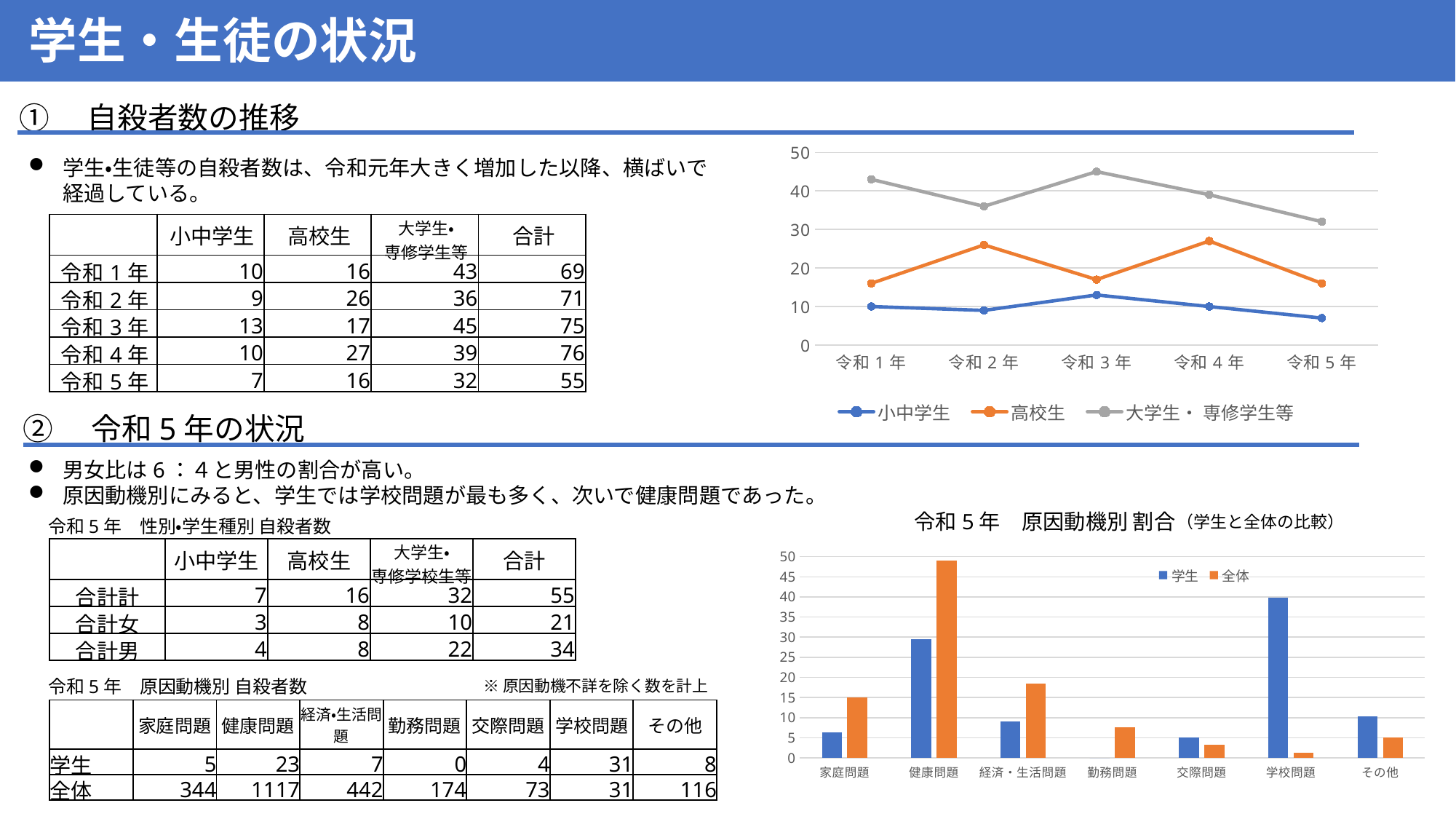
In the chart titled 令和５年 原因動機別 割合（学生と全体の比較）, which category has the highest value for 全体? 健康問題 In the top-right line chart, how many years are shown on the x axis? 5 In the top-right line chart, which series has the highest value in 令和３年? 大学生・専修学生等 In the chart titled 令和５年 原因動機別 割合（学生と全体の比較）, which category has the highest value for 学生? 学校問題 In the chart titled 令和５年 原因動機別 割合（学生と全体の比較）, is the 学生 value for 学校問題 greater or less than 30? greater In the top-right line chart, how many series does the legend list? 3 In the top-right line chart, what is the value for 小中学生 in 令和１年? 10 What kind of chart is the top-right chart showing 令和１年 to 令和５年? line chart In the top-right line chart, does the 大学生・専修学生等 line rise or fall from 令和４年 to 令和５年? fall In the top-right line chart, is the 高校生 value larger in 令和２年 or 令和３年? 令和２年 In the top-right line chart, is the value for 高校生 in 令和４年 greater or less than 20? greater What kind of chart is the chart titled 令和５年 原因動機別 割合（学生と全体の比較）? bar chart